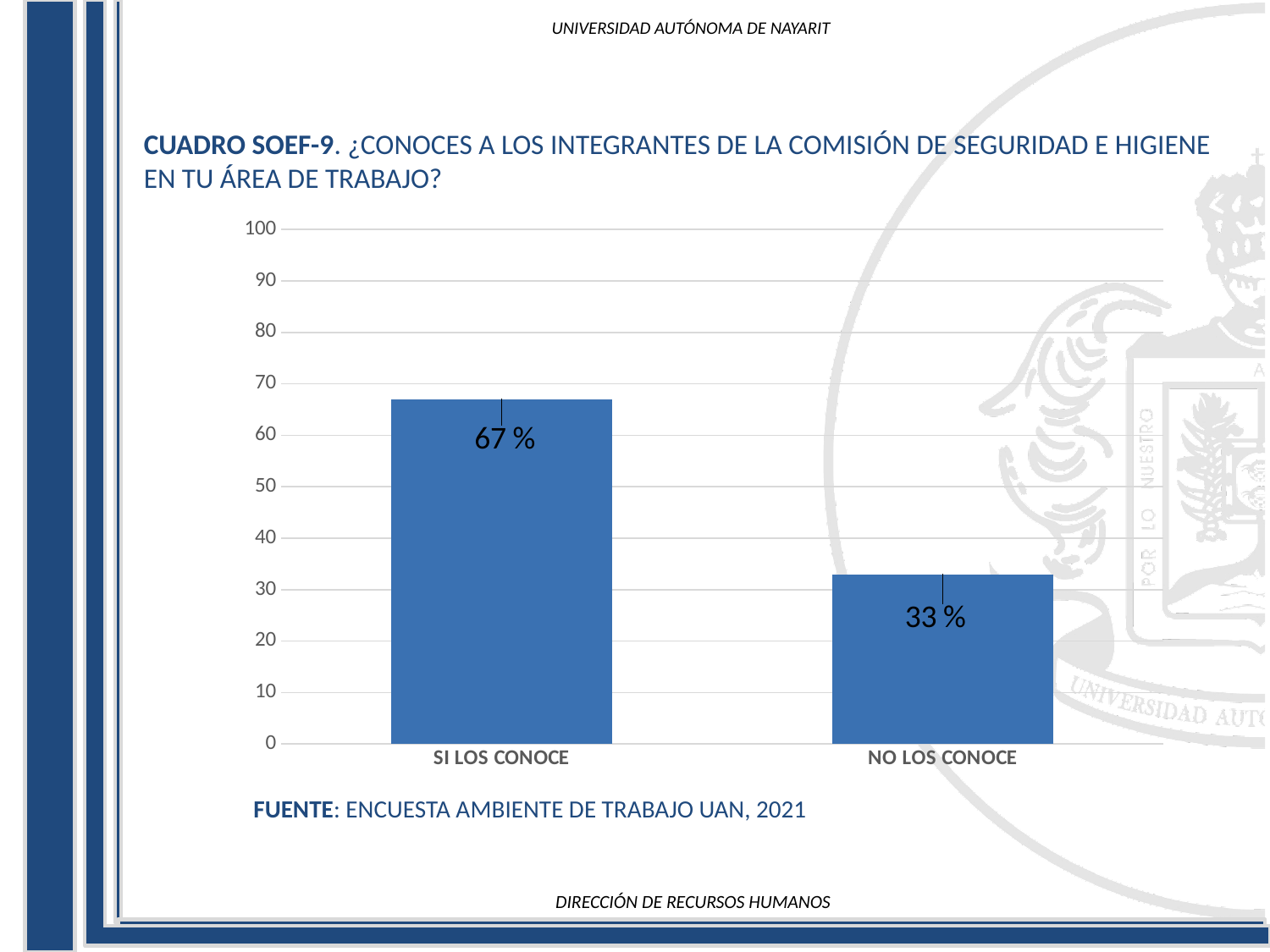
What is the value for SI LOS CONOCE? 67 % What kind of chart is shown on the slide? Bar chart Which is larger, the value for SI LOS CONOCE or NO LOS CONOCE? SI LOS CONOCE What is the value for NO LOS CONOCE? 33 % Which category has the lowest value? NO LOS CONOCE How many categories are shown on the x axis? 2 What source is cited below the chart? ENCUESTA AMBIENTE DE TRABAJO UAN, 2021 What is the difference between the values for SI LOS CONOCE and NO LOS CONOCE? 34 % What is the maximum value shown on the y axis? 100 Is the value for NO LOS CONOCE greater or less than 40? less Which category has the highest value? SI LOS CONOCE Is the value for SI LOS CONOCE greater or less than 60? greater